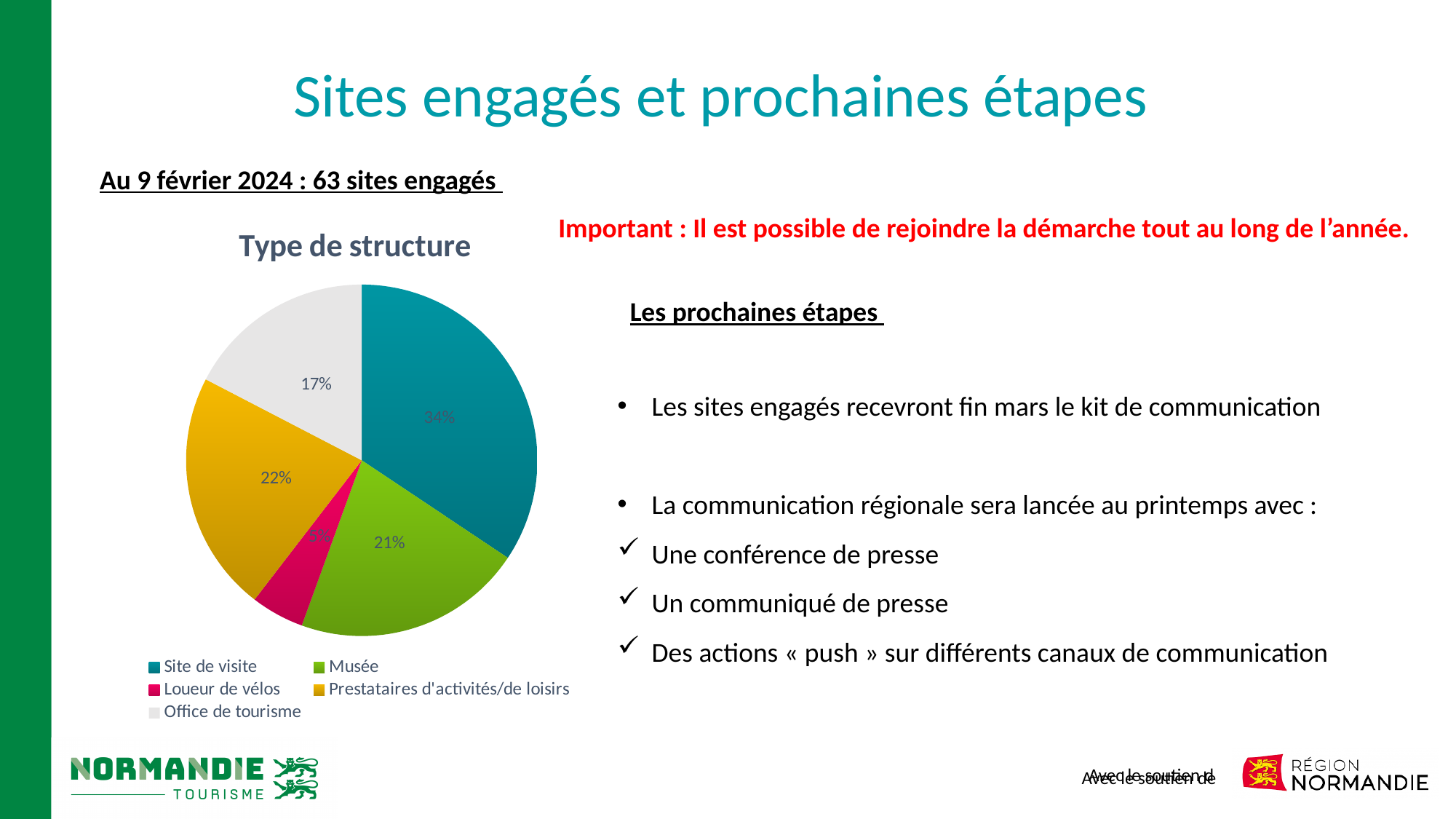
What share of the pie does Site de visite represent? 34% Which is larger, the share for Musée or the share for Office de tourisme? Musée What share of the pie does Office de tourisme represent? 17% Which category has the smallest slice of the pie? Loueur de vélos What kind of chart is shown on the slide? pie chart What share of the pie does Prestataires d'activités/de loisirs represent? 22% How many categories does the pie chart show? 5 What is the title of the chart? Type de structure What share of the pie does Musée represent? 21% What is the difference in percentage points between Site de visite and Office de tourisme? 17 What share of the pie does Loueur de vélos represent? 5% Which category has the largest slice of the pie? Site de visite